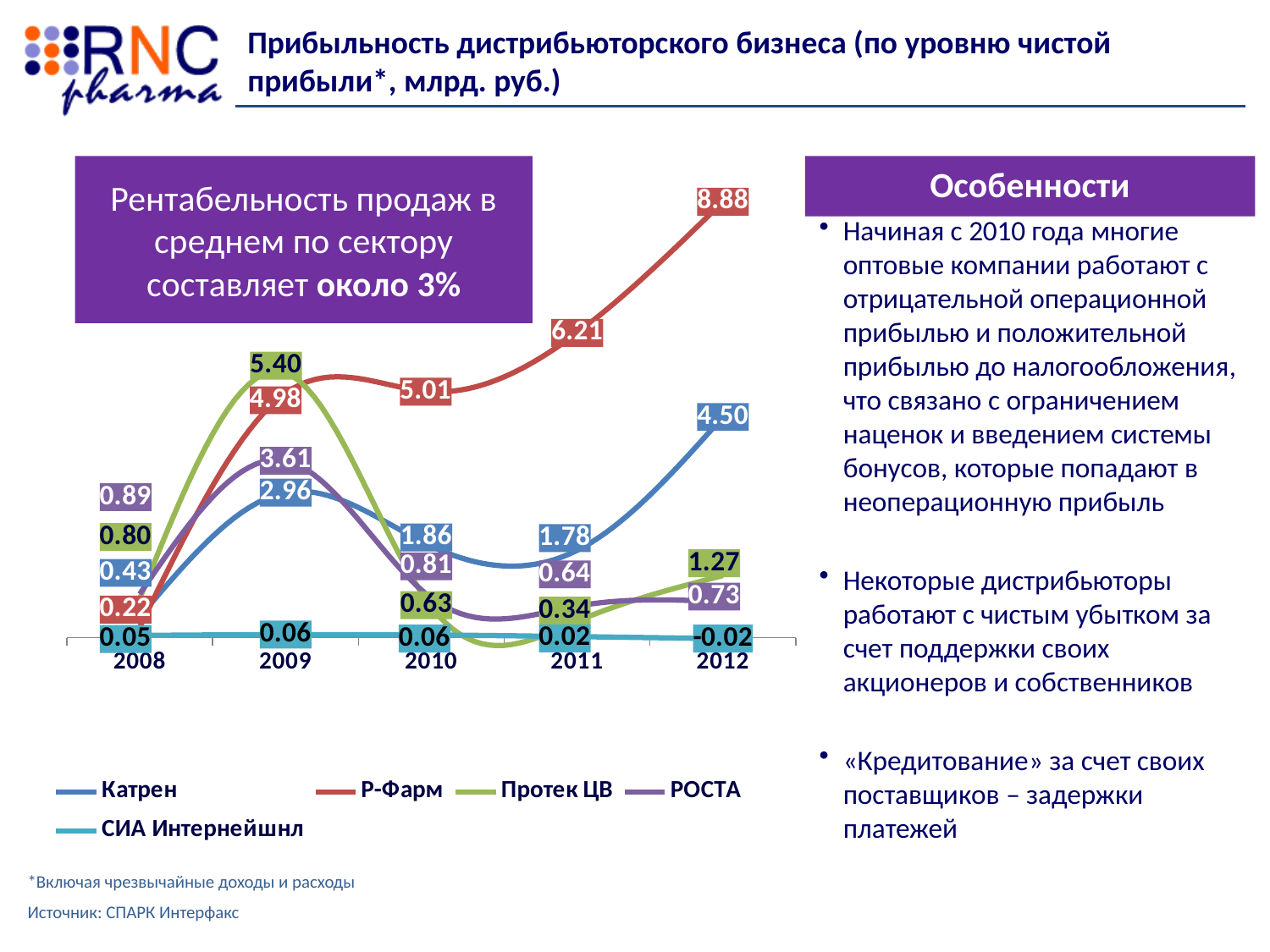
Which is larger in 2010: the value for Катрен or the value for РОСТА? Катрен What is the value for Протек ЦВ in 2011? 0.34 How many series does the legend list? 5 What is the value for Р-Фарм in 2012? 8.88 Which company has the highest value in 2009? Протек ЦВ Which company has the lowest value in 2012? СИА Интернейшнл What type of chart is shown on the slide? line chart How many years are shown on the x axis? 5 What is the value for Катрен in 2009? 2.96 What is the difference between the Р-Фарм values in 2012 and 2011? 2.67 Does the value for Р-Фарм rise or fall from 2010 to 2012? rise What is the value for СИА Интернейшнл in 2012? -0.02